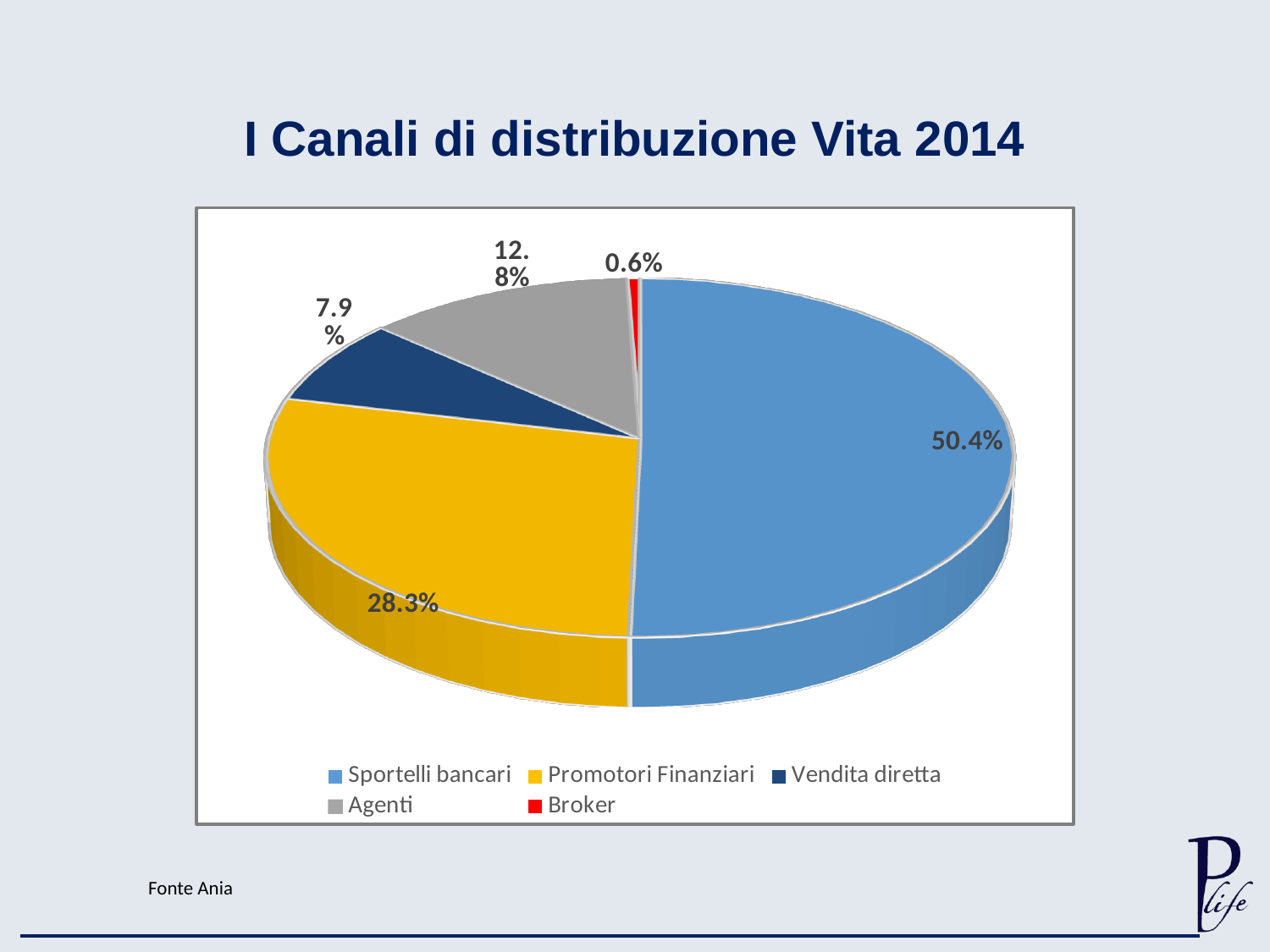
What is the value shown for Agenti? 12.8% What share of the pie does Sportelli bancari have? 50.4% What is the title of the chart on the slide? I Canali di distribuzione Vita 2014 Which has a larger share, Agenti or Vendita diretta? Agenti Which distribution channel has the smallest share of the pie? Broker What is the value shown for Broker? 0.6% What is the value shown for Promotori Finanziari? 28.3% How many slices does the pie chart have? 5 Which distribution channel has the largest share of the pie? Sportelli bancari What is the difference between the shares of Sportelli bancari and Promotori Finanziari? 22.1% What kind of chart is shown on the slide? Pie chart What is the value shown for Vendita diretta? 7.9%